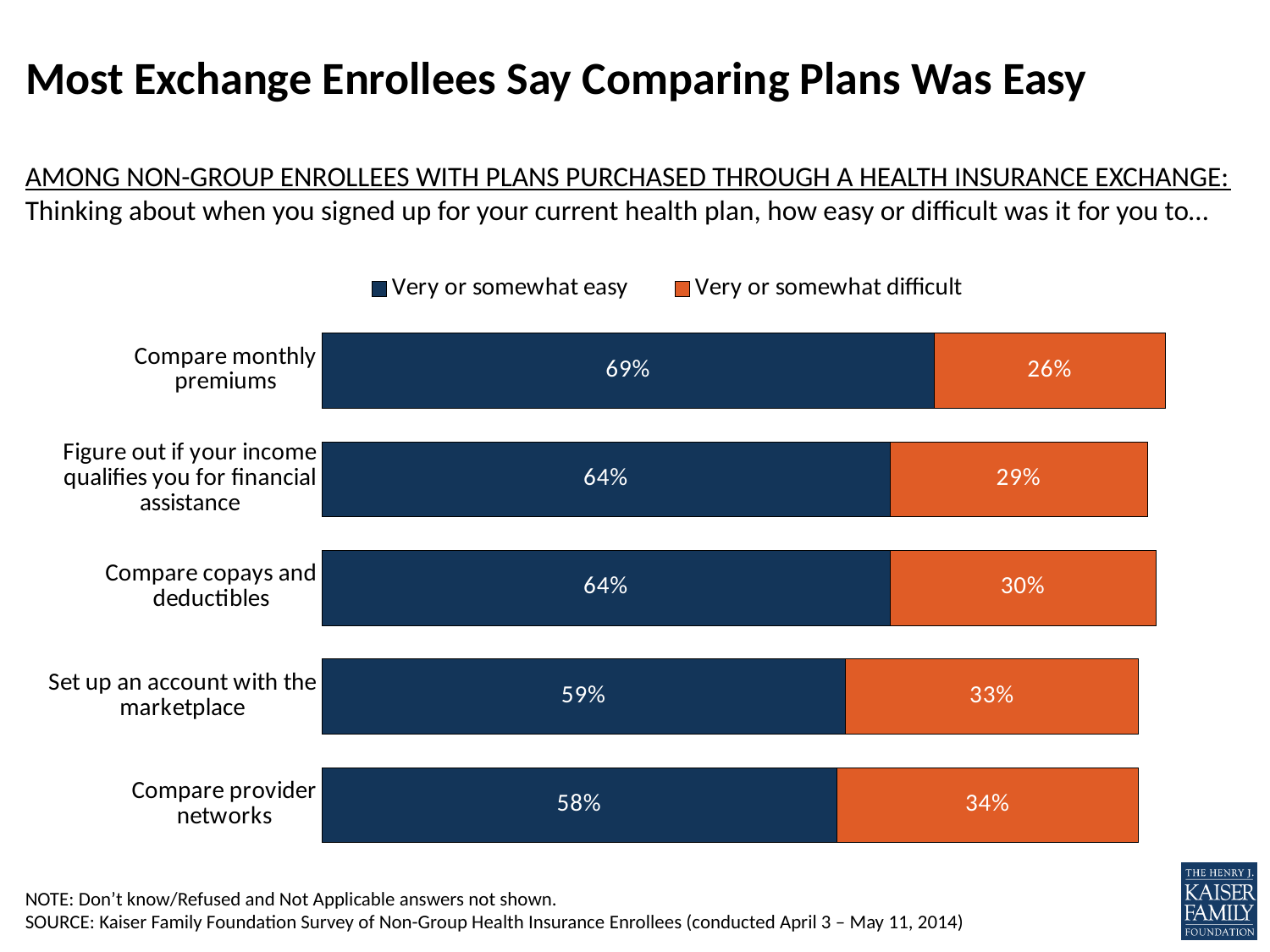
What percentage of enrollees said it was very or somewhat easy to compare monthly premiums? 69% What percentage of enrollees said it was very or somewhat difficult to compare provider networks? 34% What is the difference between the 'very or somewhat easy' percentages for comparing monthly premiums and comparing provider networks? 11 percentage points What percentage said it was very or somewhat difficult to set up an account with the marketplace? 33% How many series does the legend list? 2 What type of chart is shown on the slide? Stacked bar chart Which task had the highest share of enrollees saying it was very or somewhat difficult? Compare provider networks What is the combined percentage of easy and difficult responses for 'Figure out if your income qualifies you for financial assistance'? 93% Which task had the highest share of enrollees saying it was very or somewhat easy? Compare monthly premiums Which task had the lowest share of enrollees saying it was very or somewhat easy? Compare provider networks How many tasks are listed in the chart? 5 Is the 'very or somewhat difficult' share larger for comparing copays and deductibles or for comparing monthly premiums? Compare copays and deductibles